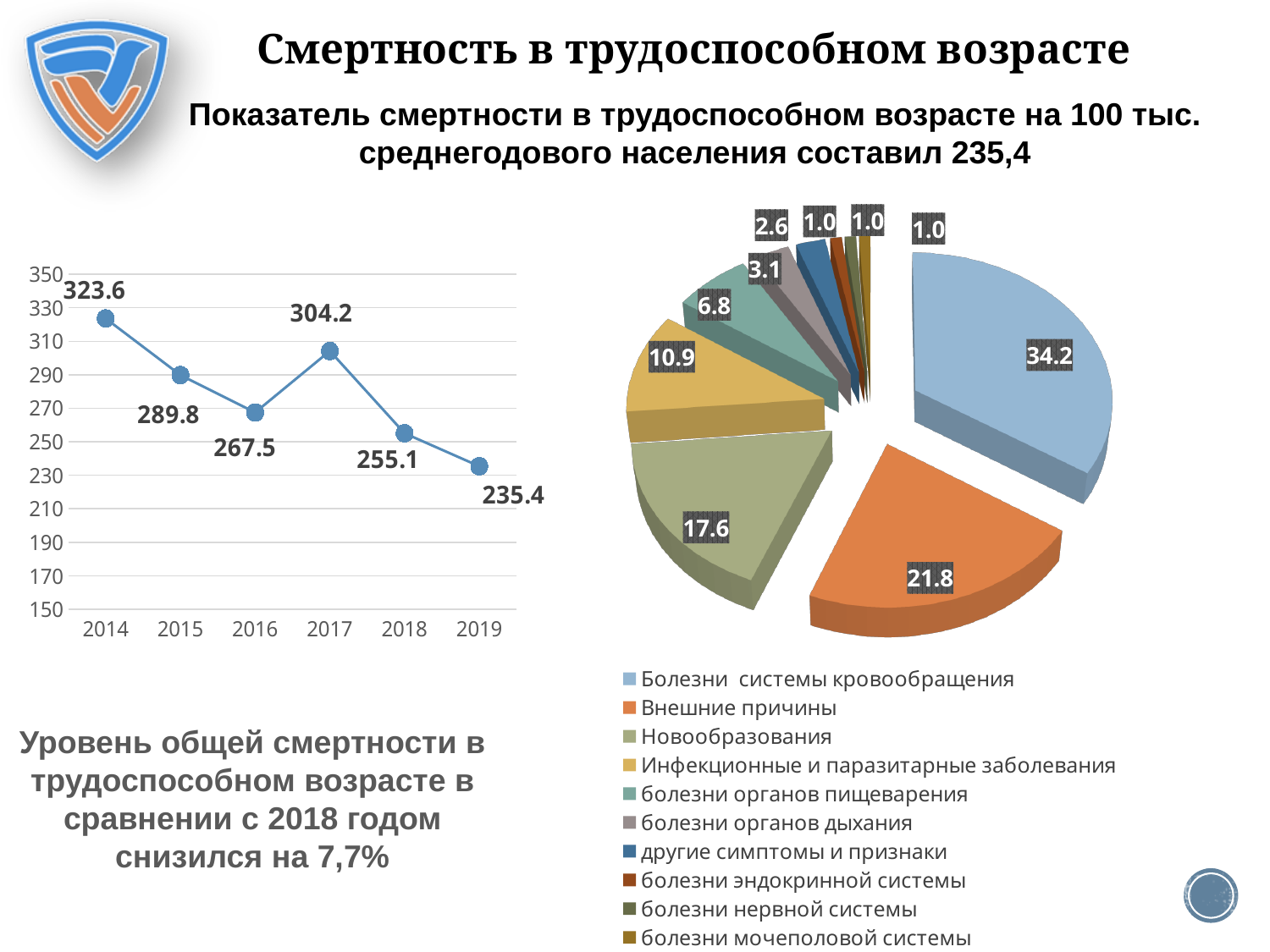
On the left line chart, what is the value for 2019? 235.4 On the right pie chart, what is the difference between Новообразования and Инфекционные и паразитарные заболевания? 6.7 On the left line chart, which year has the lowest value? 2019 How many categories does the legend of the right pie chart list? 10 On the left line chart, how many years are plotted? 6 What kind of chart is on the left side of the slide? line chart On the right pie chart, what is the value for Внешние причины? 21.8 On the right pie chart, which category has the largest slice? Болезни системы кровообращения On the left line chart, what is the difference between the values for 2018 and 2019? 19.7 On the left line chart, which is larger: the value for 2016 or the value for 2017? 2017 On the left line chart, what is the value for 2014? 323.6 On the left line chart, which year has the highest value? 2014